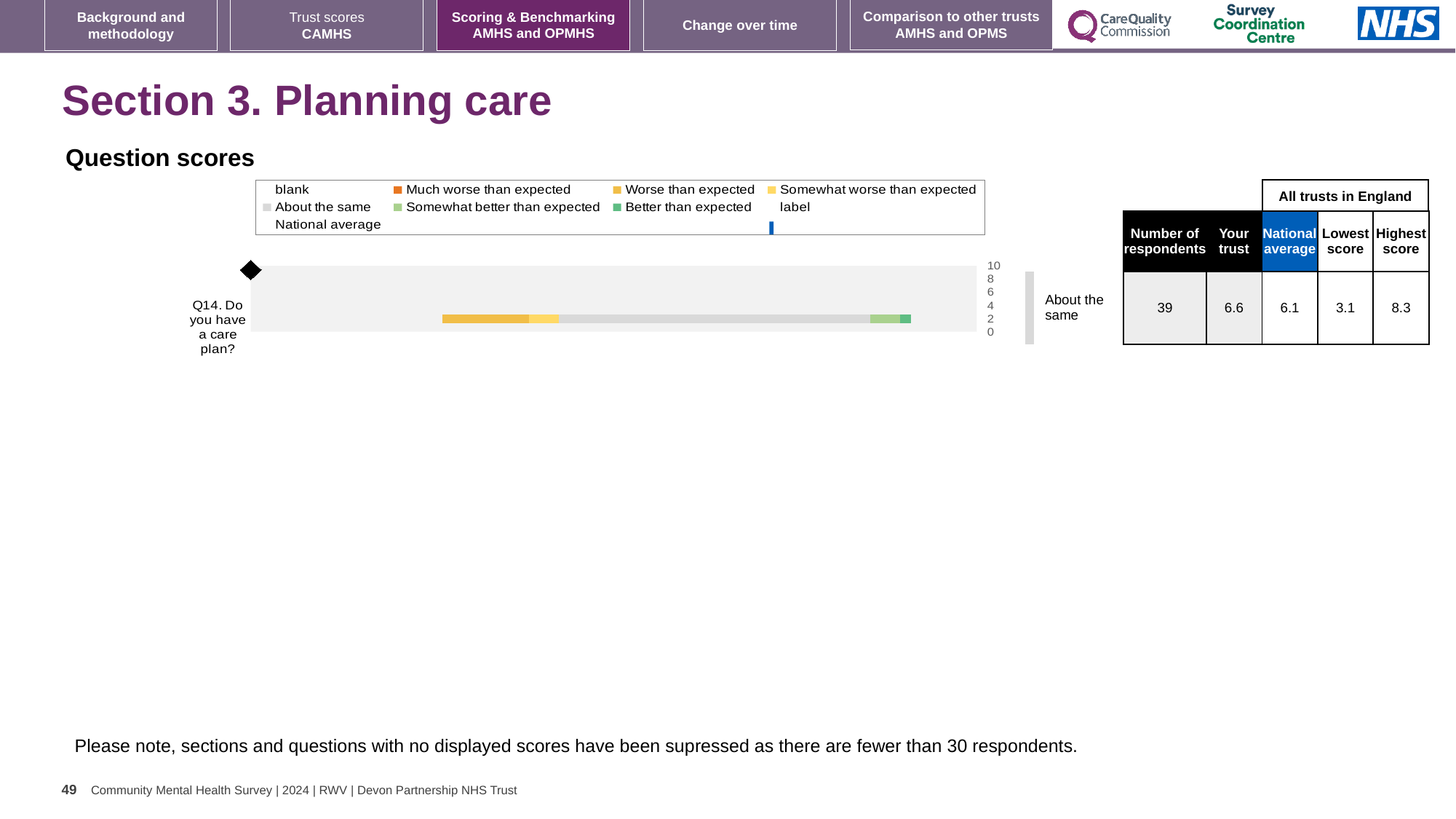
For Q14, what is the difference between the highest score and the lowest score among all trusts in England? 5.2 Which question is plotted in the Question scores chart? Q14. Do you have a care plan? What benchmark category label is shown next to the bar for Q14? About the same What is the 'Your trust' score for Q14. Do you have a care plan? 6.6 For Q14, which is higher: the 'Your trust' score or the national average? Your trust How many survey questions are plotted in the Question scores chart? 1 What is the national average score for Q14. Do you have a care plan? 6.1 For Q14, how much higher is the 'Your trust' score than the national average? 0.5 How many respondents answered Q14. Do you have a care plan? 39 What is the highest score among all trusts in England for Q14? 8.3 What is the lowest score among all trusts in England for Q14? 3.1 What type of chart is used to show the Q14 question score? bar chart